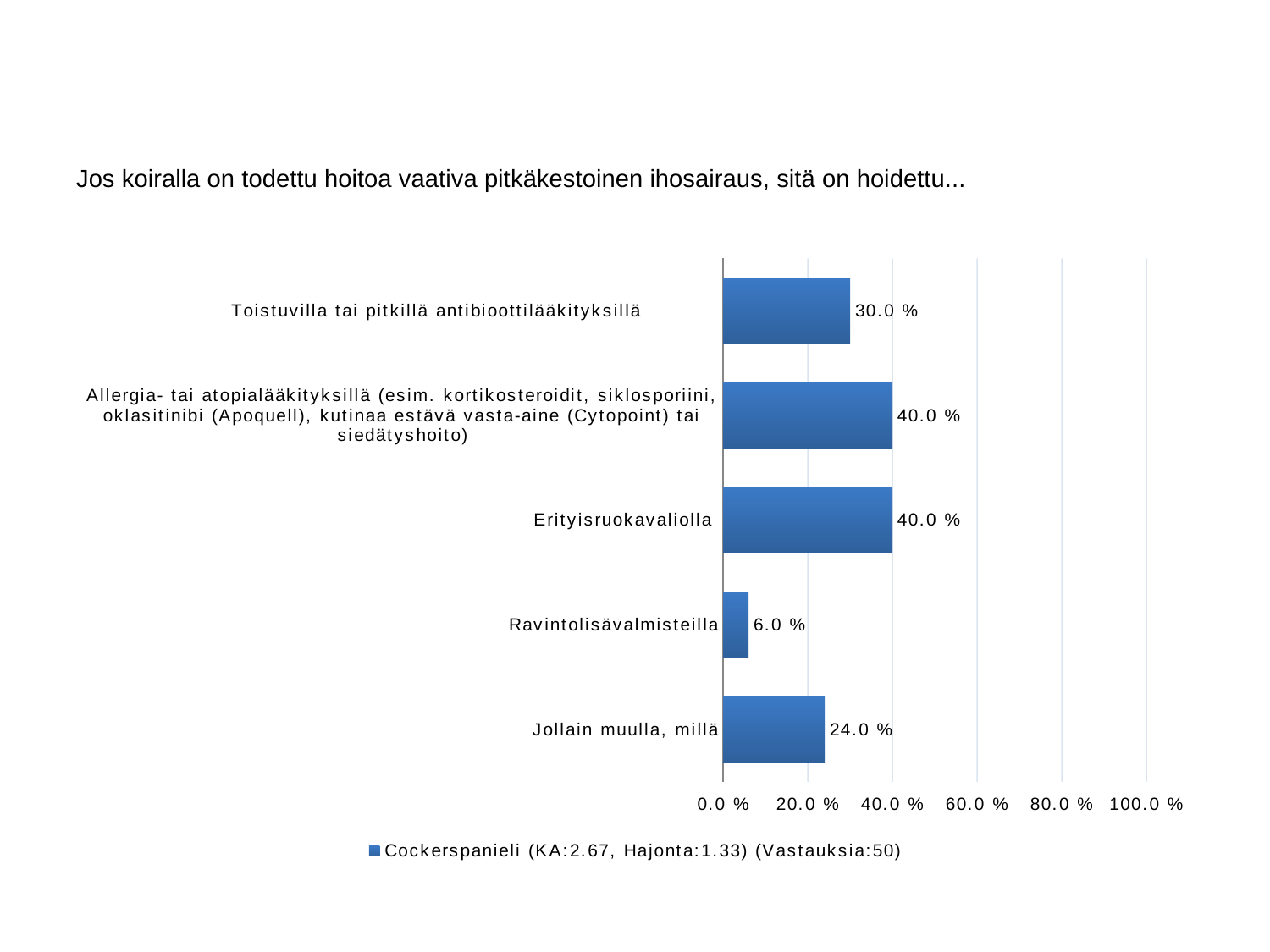
Which is larger, the value for Toistuvilla tai pitkillä antibioottilääkityksillä or the value for Jollain muulla, millä? Toistuvilla tai pitkillä antibioottilääkityksillä What kind of chart is shown on the slide? Bar chart What is the value for Erityisruokavaliolla? 40.0 % What is the difference between the values for Erityisruokavaliolla and Ravintolisävalmisteilla? 34.0 % What is the difference between the values for Toistuvilla tai pitkillä antibioottilääkityksillä and Jollain muulla, millä? 6.0 % How many categories are shown in the chart? 5 Which category has the lowest value? Ravintolisävalmisteilla What is the value for Toistuvilla tai pitkillä antibioottilääkityksillä? 30.0 % What is the value for Jollain muulla, millä? 24.0 % What is the value for Ravintolisävalmisteilla? 6.0 % How many responses (Vastauksia) does the legend entry report? 50 How many series does the legend list? 1